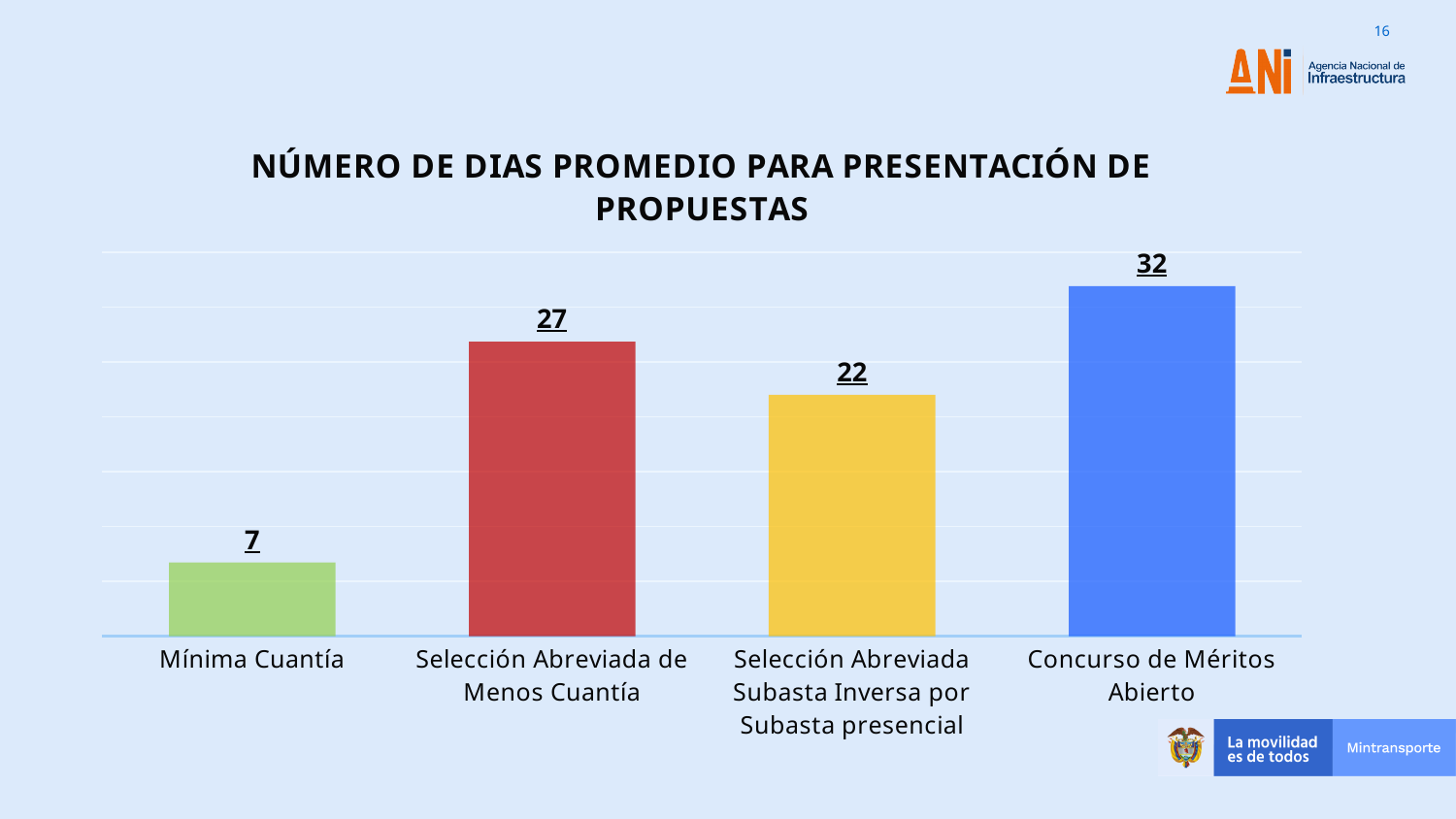
Which category has the lowest value? Mínima Cuantía What is the value for Selección Abreviada de Menos Cuantía? 27 What is the value for Concurso de Méritos Abierto? 32 What is the value for Selección Abreviada Subasta Inversa por Subasta presencial? 22 What kind of chart is shown on the slide? Bar chart What is the title of the chart? NÚMERO DE DIAS PROMEDIO PARA PRESENTACIÓN DE PROPUESTAS What is the value for Mínima Cuantía? 7 Which category has the highest value? Concurso de Méritos Abierto Which is larger, the value for Selección Abreviada de Menos Cuantía or the value for Selección Abreviada Subasta Inversa por Subasta presencial? Selección Abreviada de Menos Cuantía How many categories are shown in the chart? 4 What is the difference between the values for Concurso de Méritos Abierto and Mínima Cuantía? 25 What is the difference between the values for Selección Abreviada de Menos Cuantía and Selección Abreviada Subasta Inversa por Subasta presencial? 5